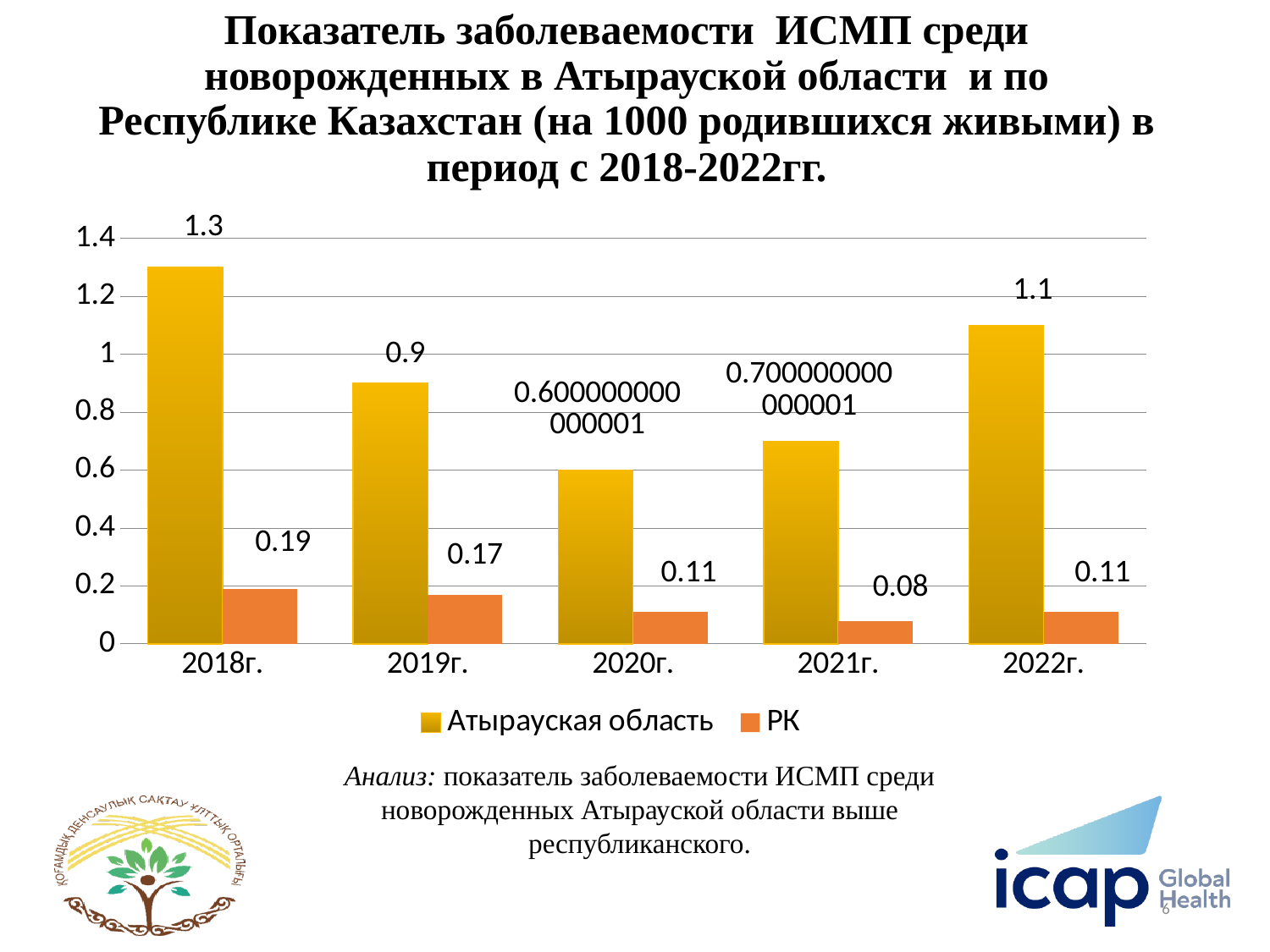
What is the value for РК in 2021г.? 0.08 What is the value for Атырауская область in 2018г.? 1.3 What is the difference between the Атырауская область values for 2018г. and 2022г.? 0.2 In which year is the value for РК lowest? 2021г. What is the value for РК in 2019г.? 0.17 Is the value for Атырауская область in 2020г. greater or less than 0.8? less In which year is the value for Атырауская область highest? 2018г. Which is larger: the Атырауская область value in 2019г. or in 2021г.? 2019г. How many series does the legend list? 2 What kind of chart is shown on the slide? bar chart What is the difference between the РК values for 2018г. and 2021г.? 0.11 What is the value for Атырауская область in 2022г.? 1.1